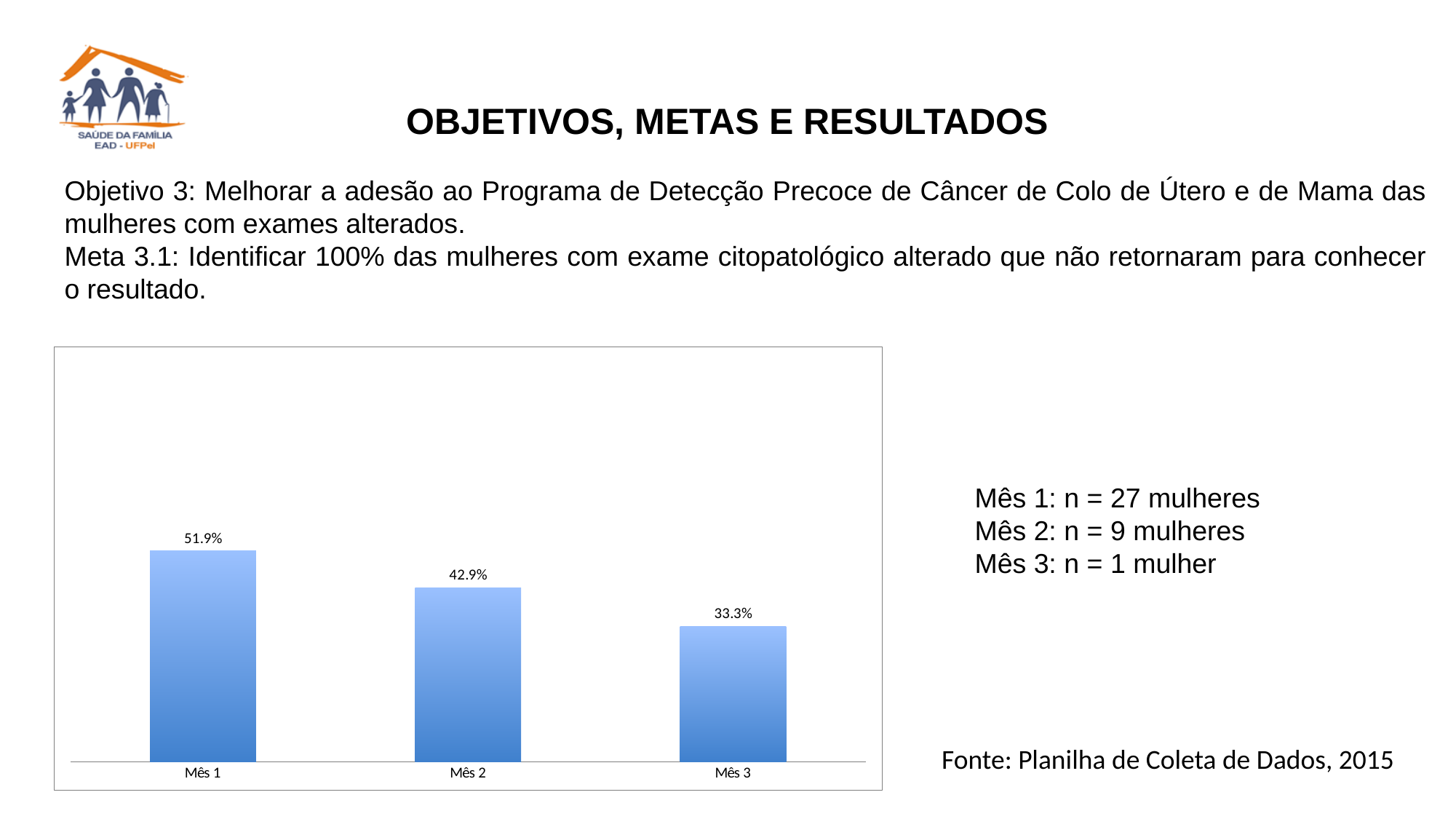
Which month has the highest value? Mês 1 What is the difference between the values for Mês 1 and Mês 2? 9.0% What is the value for Mês 1? 51.9% What is the value for Mês 3? 33.3% Do the values rise or fall from Mês 1 to Mês 3? Fall What kind of chart is shown on the slide? Bar chart Which month has the lowest value? Mês 3 What is the value for Mês 2? 42.9% Which is larger, the value for Mês 2 or the value for Mês 3? Mês 2 What is the difference between the values for Mês 1 and Mês 3? 18.6% How many categories are shown on the x axis of the chart? 3 What colour are the bars in the chart? Blue